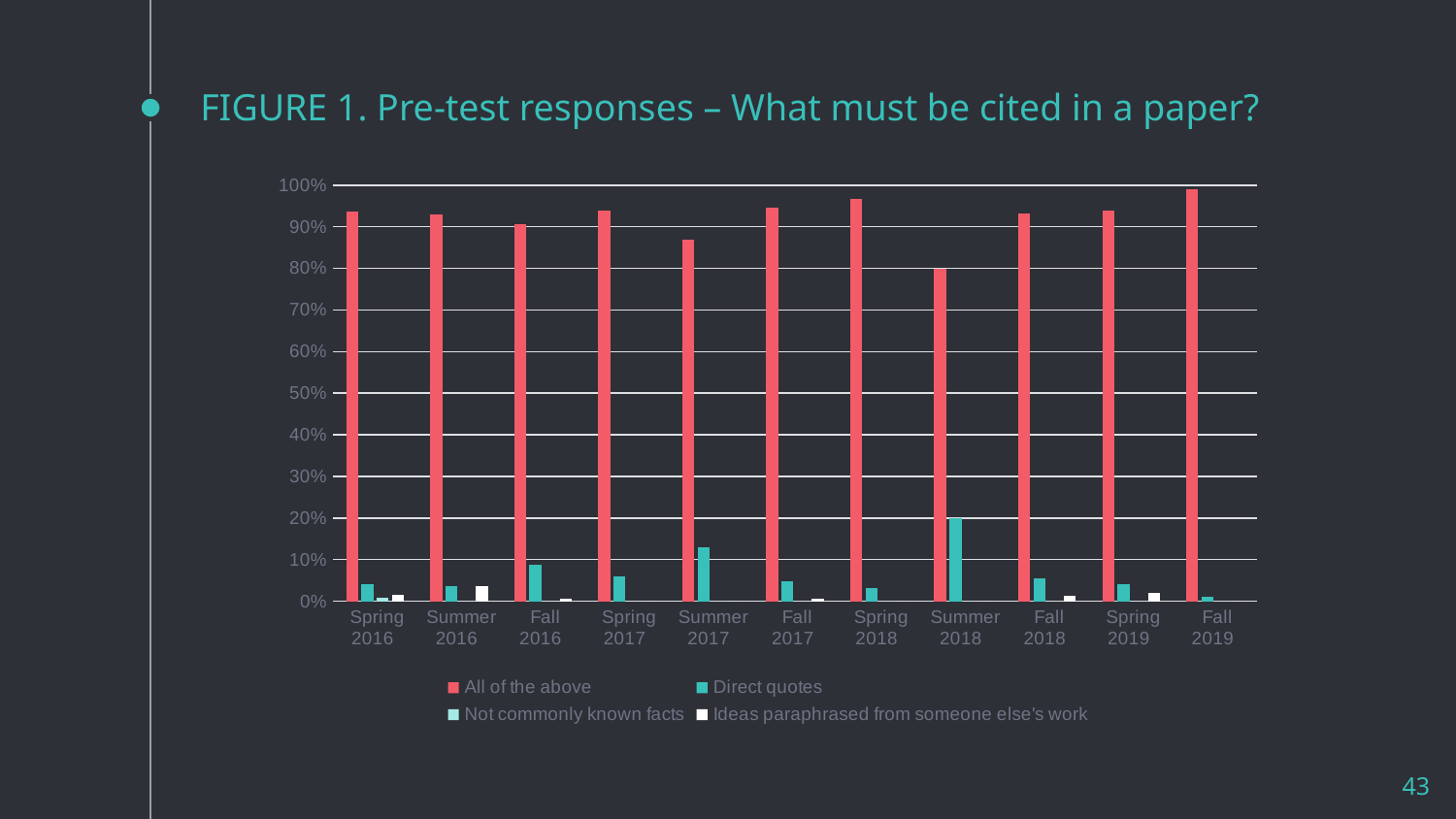
Is the 'All of the above' value for Summer 2018 greater or less than 90%? less Which series is shown in red in the legend? All of the above Which is larger: the 'Direct quotes' value for Summer 2018 or for Summer 2017? Summer 2018 How many series does the legend list? 4 How many terms (categories) are shown along the x axis? 11 In which term is the 'Direct quotes' value highest? Summer 2018 In which term is the 'All of the above' value lowest? Summer 2018 What is the title of the chart? FIGURE 1. Pre-test responses – What must be cited in a paper? In which term is the 'All of the above' value highest? Fall 2019 Is the 'All of the above' value for Fall 2019 greater or less than 90%? greater Is the 'Direct quotes' value for Summer 2018 greater or less than 10%? greater What kind of chart is shown on the slide? bar chart